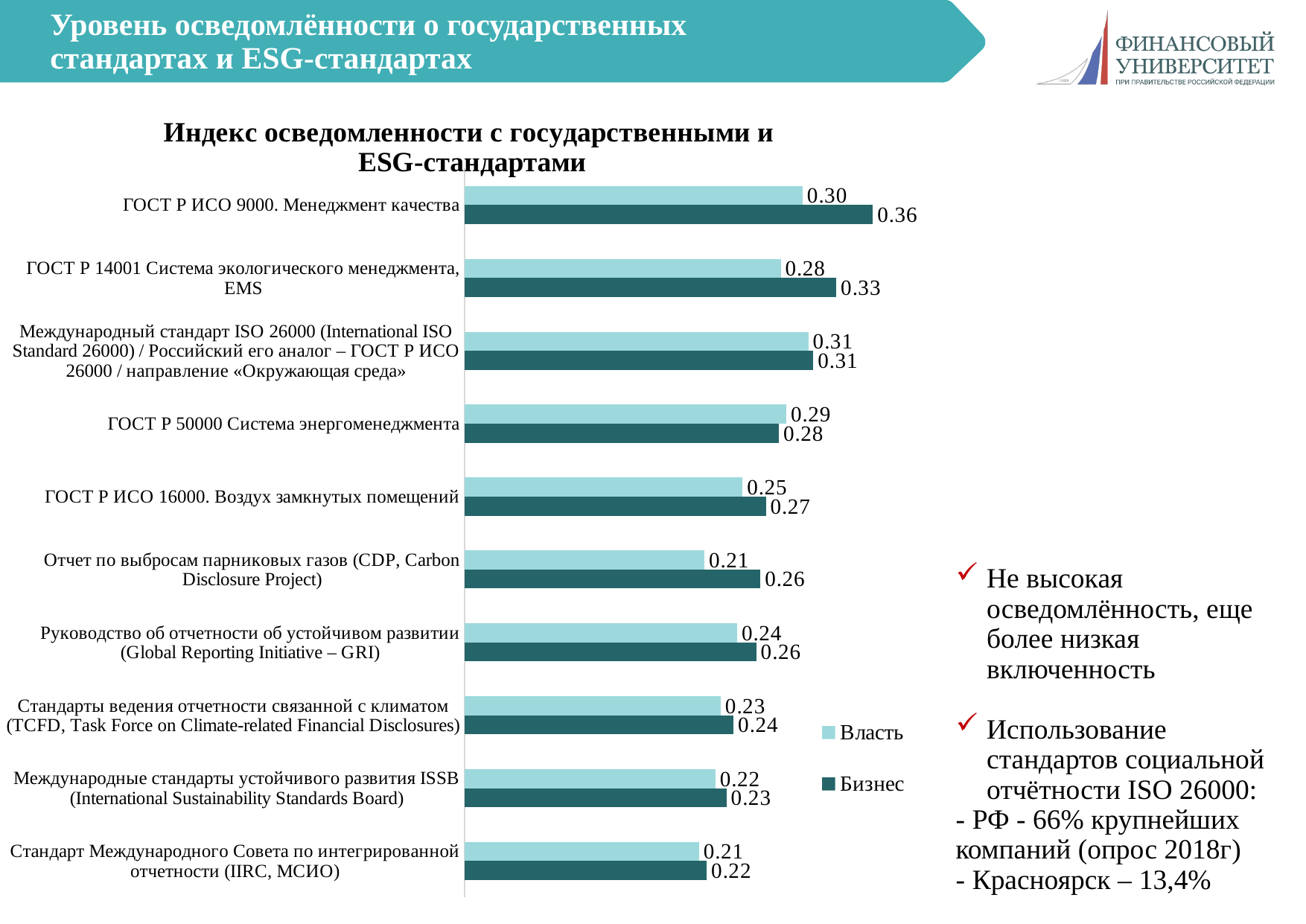
For ГОСТ Р 50000 Система энергоменеджмента, which is larger: the Власть value or the Бизнес value? Власть How many series does the chart legend list? 2 What type of chart is shown on the slide? bar chart Which category has the lowest Бизнес value? Стандарт Международного Совета по интегрированной отчетности (IIRC, МСИО) What are the two legend entries of the chart? Власть and Бизнес What is the Бизнес value for ГОСТ Р ИСО 9000. Менеджмент качества? 0.36 Which category has the highest Бизнес value? ГОСТ Р ИСО 9000. Менеджмент качества What is the Власть value for ГОСТ Р 14001 Система экологического менеджмента, EMS? 0.28 Which category has the highest Власть value? Международный стандарт ISO 26000 (International ISO Standard 26000) / Российский его аналог – ГОСТ Р ИСО 26000 / направление «Окружающая среда» How many categories (standards) are shown in the chart? 10 What is the difference between the Бизнес and Власть values for ГОСТ Р ИСО 9000. Менеджмент качества? 0.06 What is the Бизнес value for Отчет по выбросам парниковых газов (CDP, Carbon Disclosure Project)? 0.26